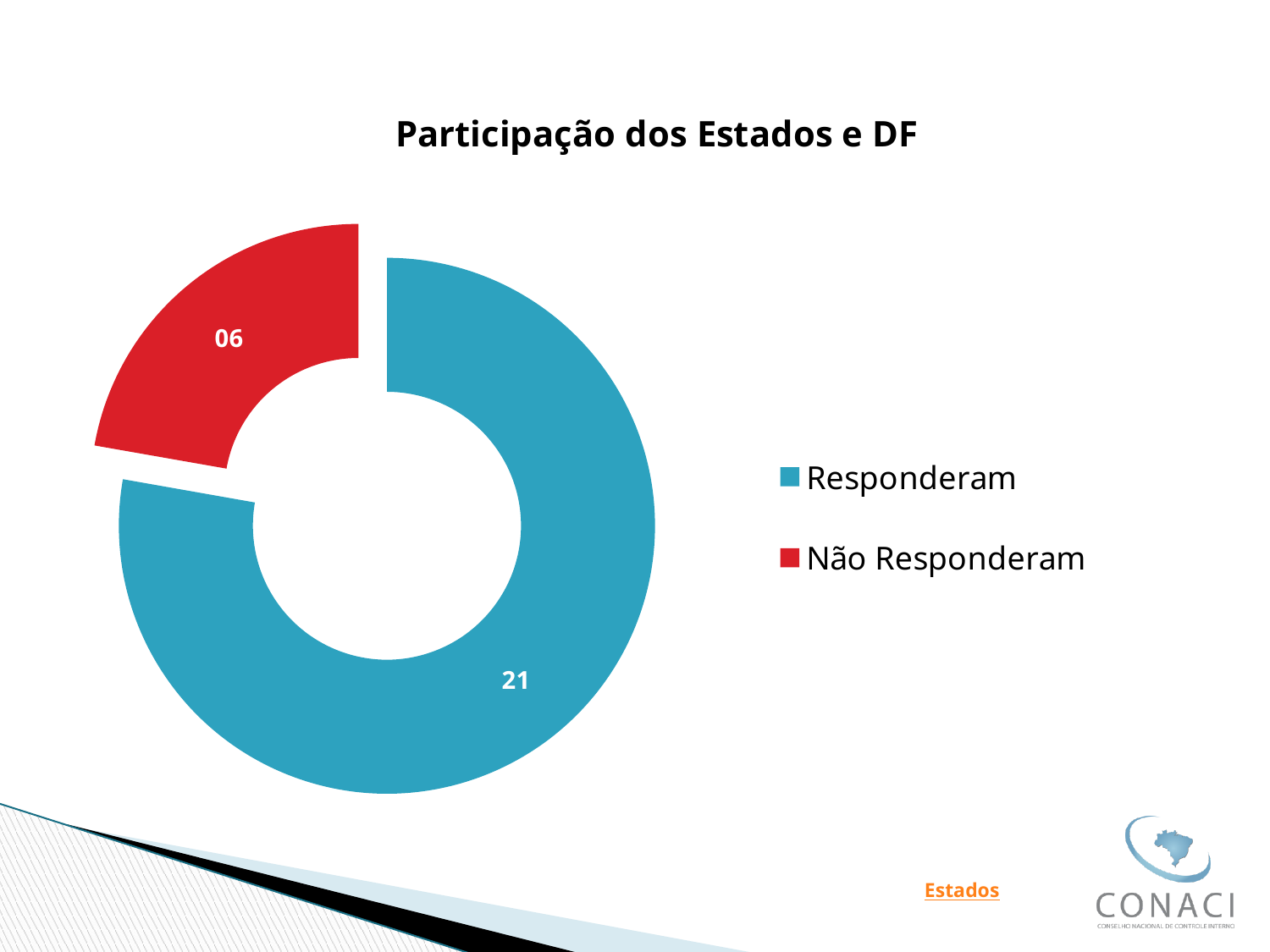
How many entries does the legend list? 2 What colour is the Não Responderam slice? red What is the value for Responderam? 21 What is the total of the two values shown in the chart? 27 How many categories does the chart show? 2 What kind of chart is shown on the slide? doughnut chart What is the value for Não Responderam? 06 Which category has the largest slice? Responderam Which is larger, Responderam or Não Responderam? Responderam What is the title of the chart? Participação dos Estados e DF What is the difference between the values for Responderam and Não Responderam? 15 Which category has the smallest slice? Não Responderam